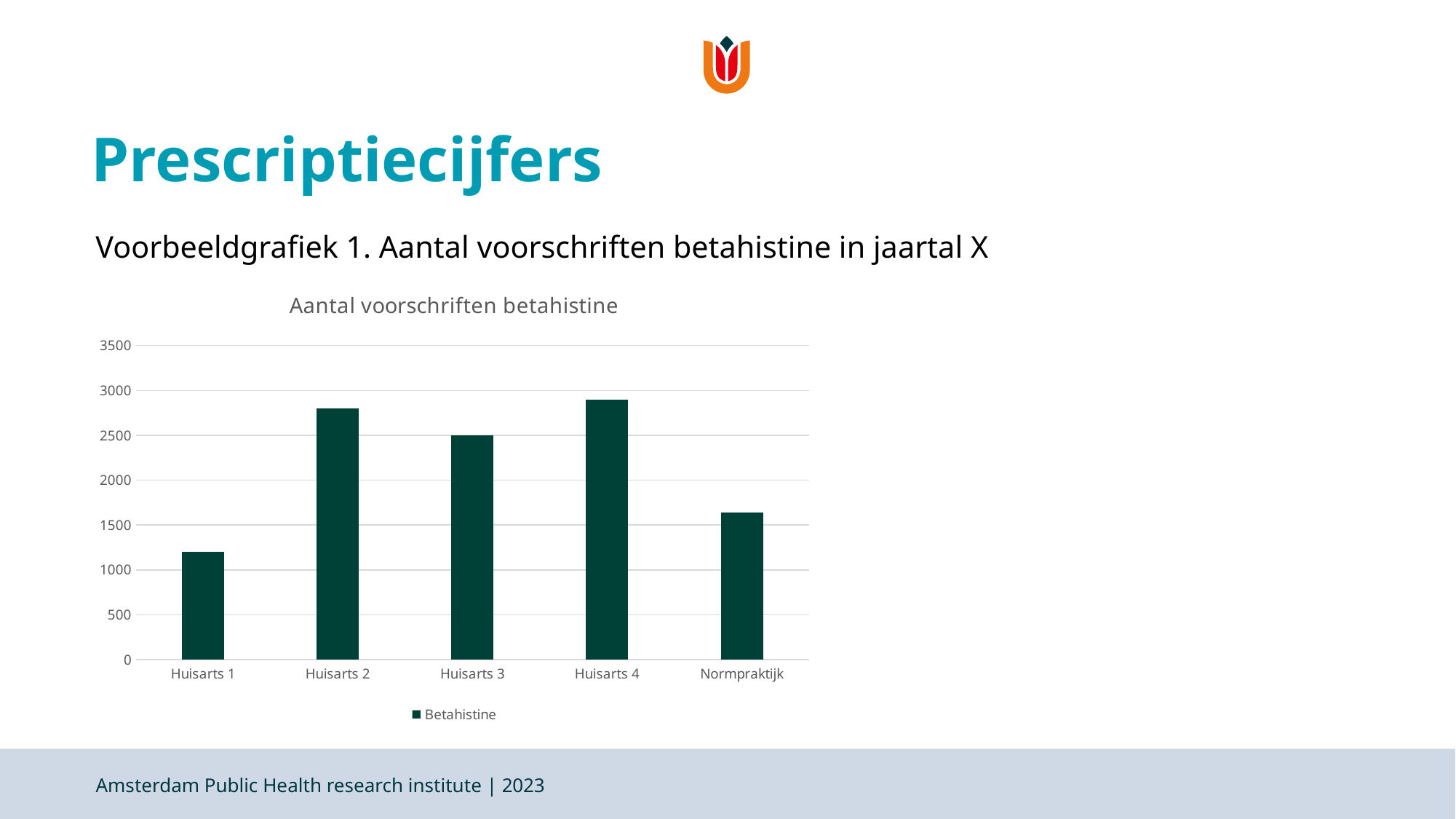
Is the value for Huisarts 4 greater or less than 3000? less Which category has the highest number of betahistine prescriptions? Huisarts 4 Which category has the lowest number of betahistine prescriptions? Huisarts 1 Is the value for Huisarts 1 greater or less than 1500? less What kind of chart is shown on the slide? Bar chart Is the value for Normpraktijk greater or less than 1500? greater How many series does the chart's legend list? 1 What is the name of the series in the chart's legend? Betahistine Which has more betahistine prescriptions, Huisarts 2 or Huisarts 3? Huisarts 2 What is the title of the chart? Aantal voorschriften betahistine How many categories are shown on the x axis of the chart? 5